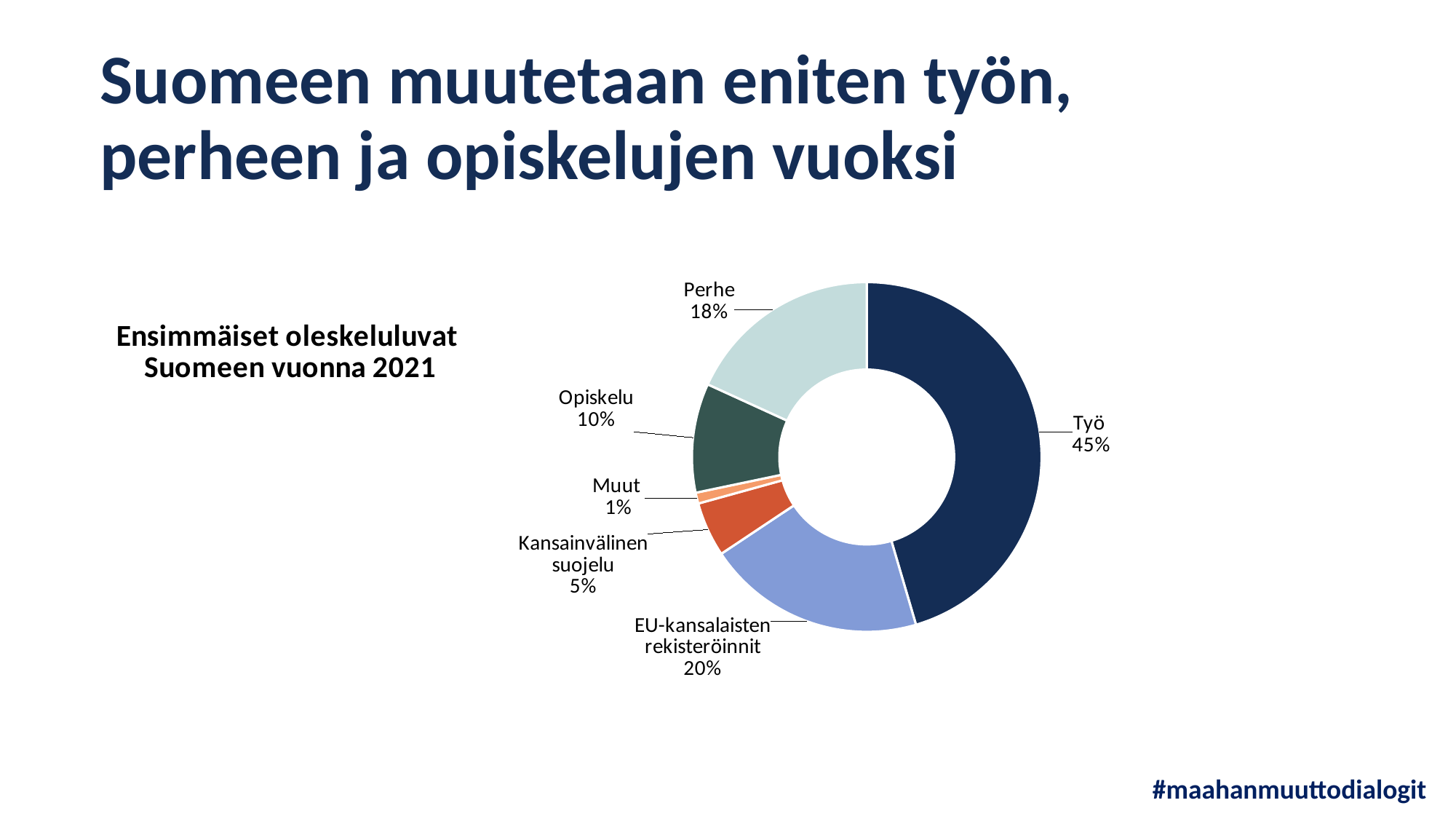
Which category has the largest share? Työ What is the difference between the shares for Opiskelu and Kansainvälinen suojelu? 5% What kind of chart is shown on the slide? Pie chart (doughnut) What is the value shown for Perhe? 18% What share of the chart does Työ represent? 45% What is the difference between the shares for Työ and Perhe? 27% Which category has the smallest share? Muut What is the value shown for EU-kansalaisten rekisteröinnit? 20% Which is larger, the share for EU-kansalaisten rekisteröinnit or the share for Perhe? EU-kansalaisten rekisteröinnit What is the value shown for Kansainvälinen suojelu? 5% How many categories are shown in the chart? 6 What is the title of the chart? Ensimmäiset oleskeluluvat Suomeen vuonna 2021